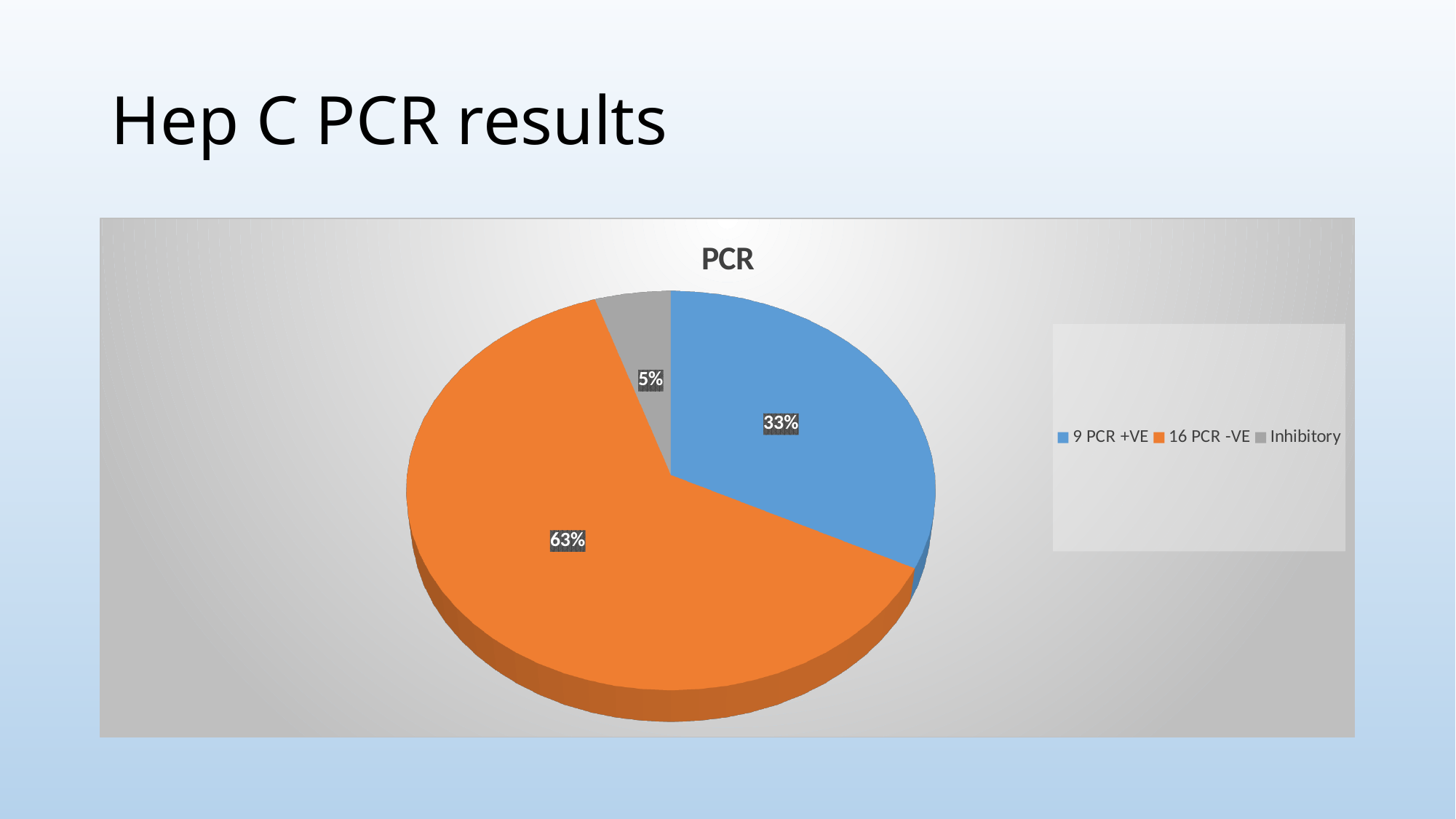
What colour is the "16 PCR -VE" slice? orange How many slices does the pie chart have? 3 What is the title of the chart? PCR Which is larger, the "9 PCR +VE" slice or the "Inhibitory" slice? 9 PCR +VE Which category has the smallest slice of the pie? Inhibitory Which category has the largest slice of the pie? 16 PCR -VE What share of the pie does the "16 PCR -VE" slice represent? 63% What is the difference in percentage points between the "16 PCR -VE" slice and the "9 PCR +VE" slice? 30% What type of chart is shown on the slide? pie chart How many entries does the legend list? 3 What share of the pie does the "Inhibitory" slice represent? 5% What share of the pie does the "9 PCR +VE" slice represent? 33%